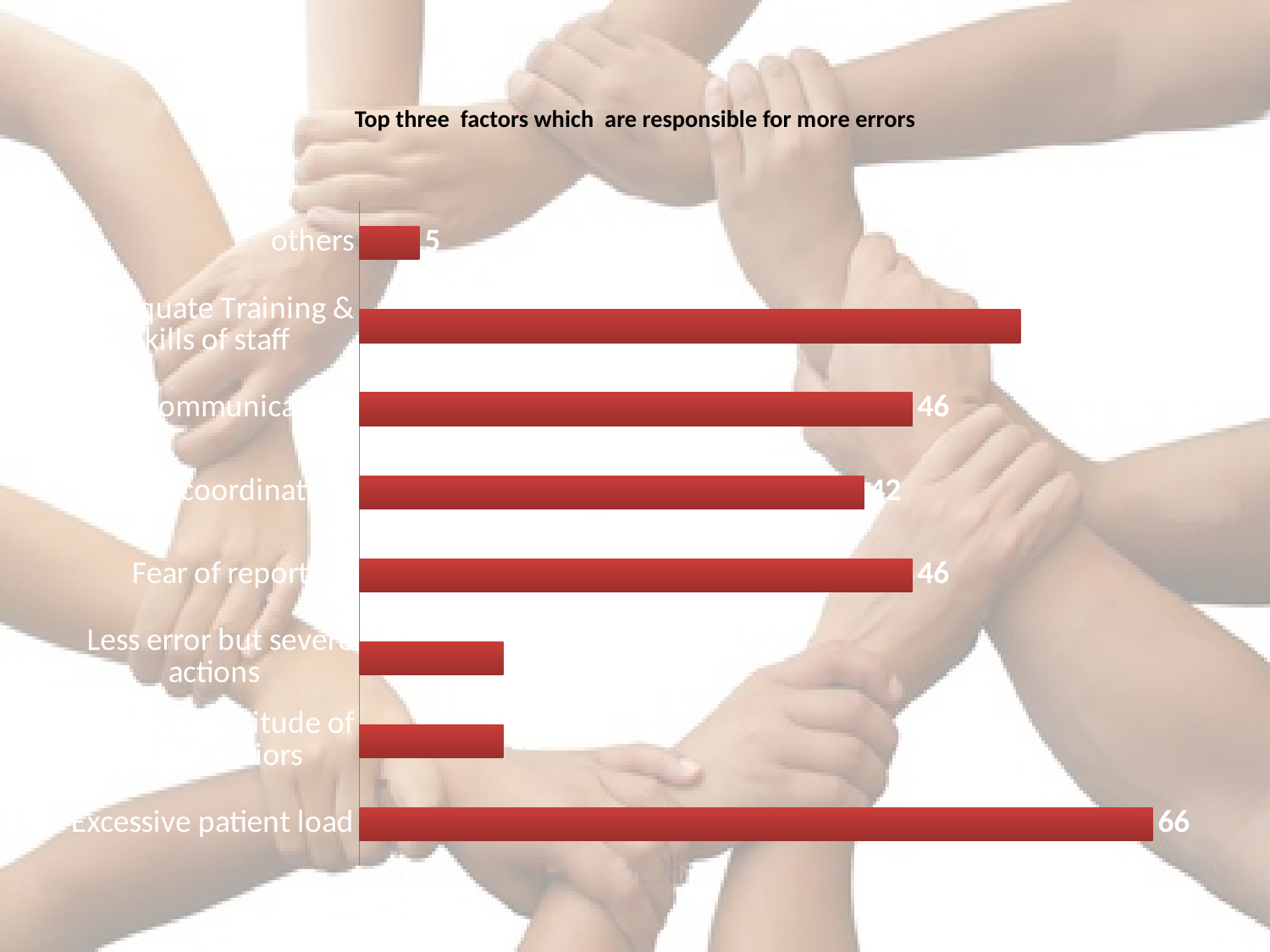
What is the value for Excessive patient load? 66 What kind of chart is shown on the slide? bar chart Which is larger, the value for Excessive patient load or the value for Less error but severe actions? Excessive patient load What is the difference between the values for Excessive patient load and others? 61 Which category has the highest value? Excessive patient load What is the title of the chart? Top three factors which are responsible for more errors Which category has the lowest value? others What is the value for Fear of reporting? 46 What is the value for others? 5 Which is larger, the value for Fear of reporting or the value for others? Fear of reporting How many categories are plotted in the chart? 8 What is the difference between the values for Fear of reporting and others? 41